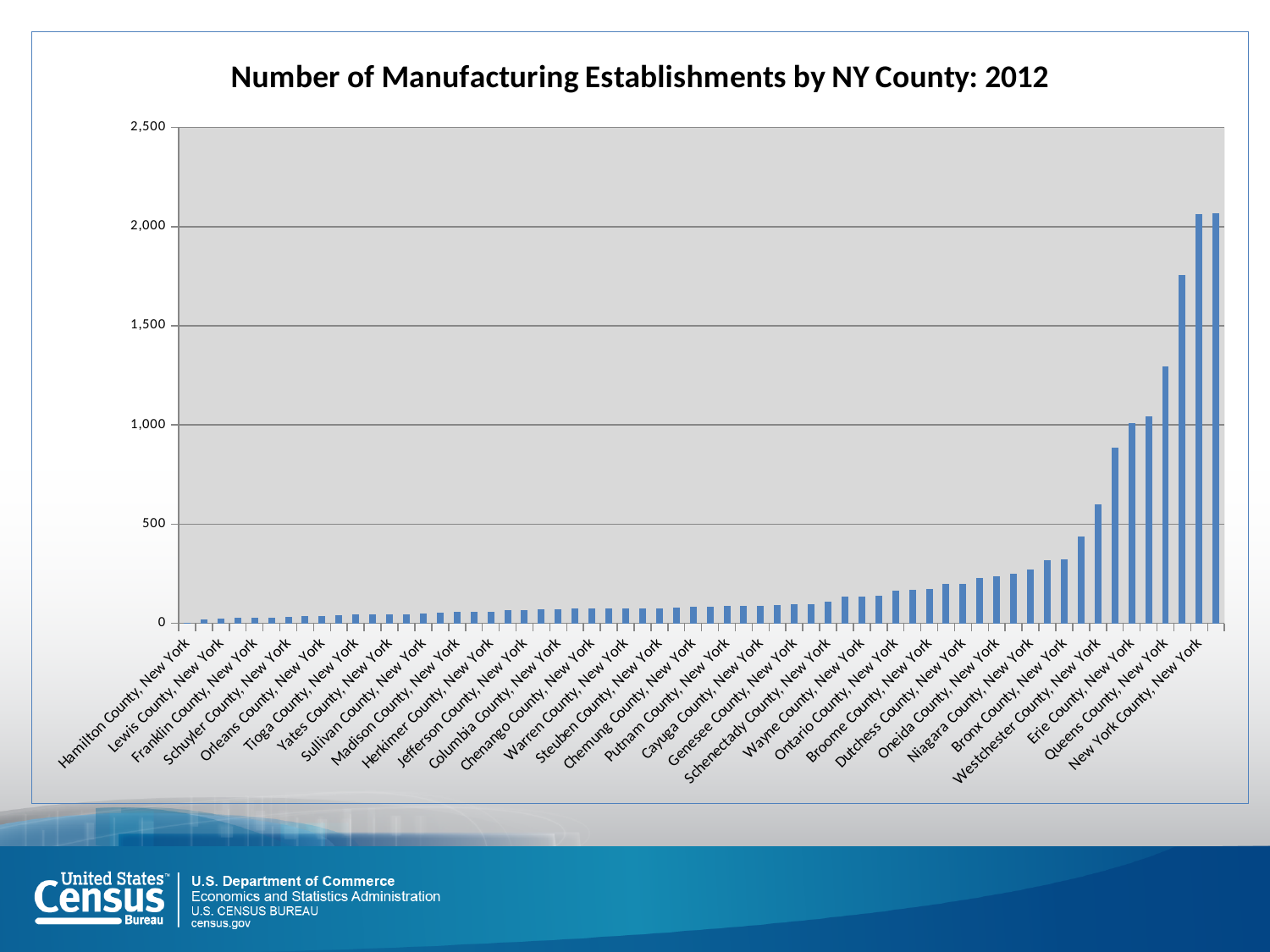
What is the highest value shown on the vertical axis? 2,500 What is the title of the chart? Number of Manufacturing Establishments by NY County: 2012 Is the value for Hamilton County, New York greater or less than 500? less Do the values rise or fall moving from left to right along the x axis? rise Is the value for Bronx County, New York greater or less than 500? less Is the value for Westchester County, New York greater or less than 1,000? less Which county has the lowest number of manufacturing establishments? Hamilton County, New York What kind of chart is shown on the slide? bar chart Which has more manufacturing establishments, Queens County or Erie County? Queens County, New York Which has more manufacturing establishments, Hamilton County or Erie County? Erie County, New York